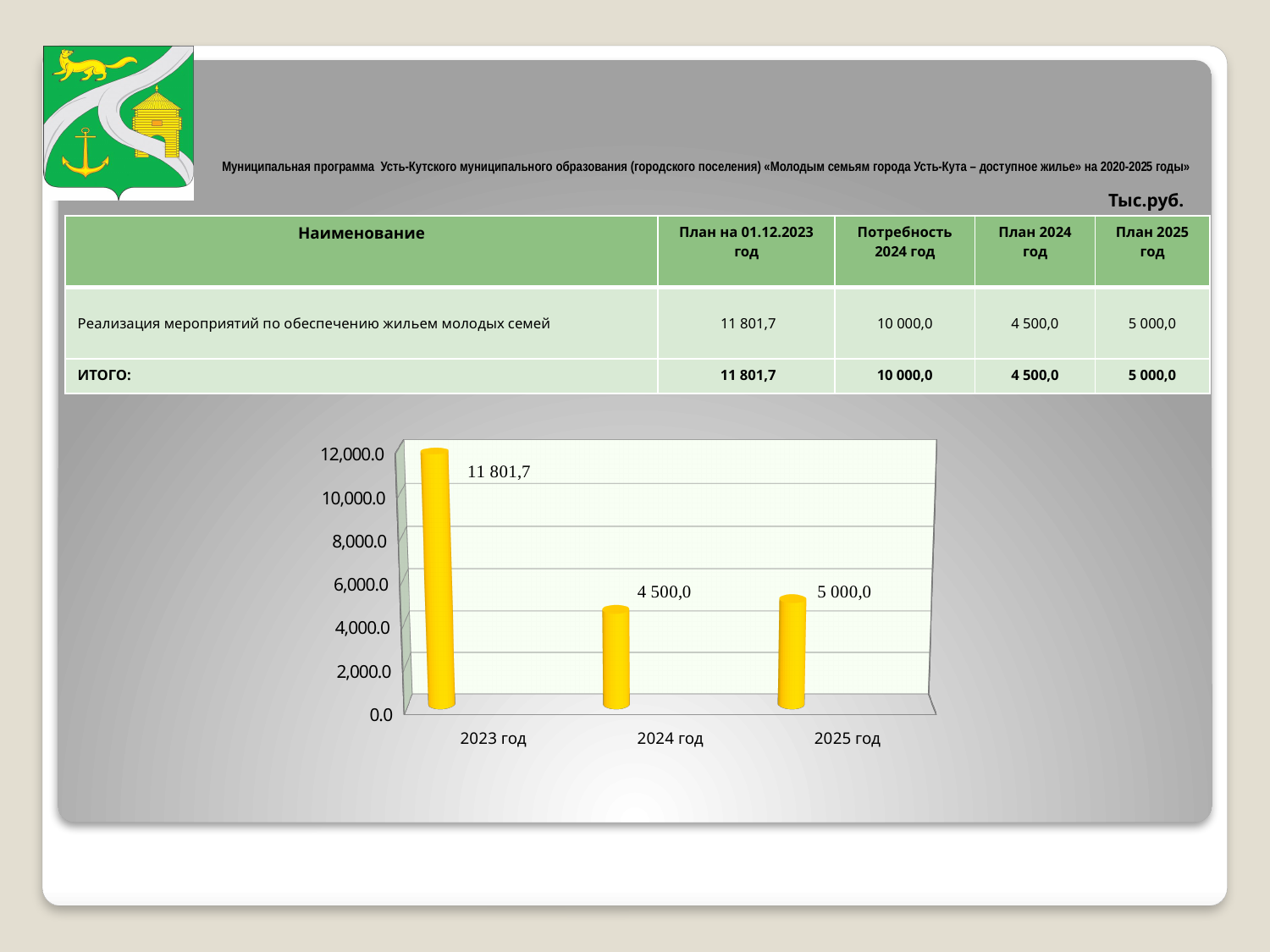
What is the value shown for 2023 год in the chart? 11 801,7 What is the value shown for 2025 год in the chart? 5 000,0 What kind of chart is shown on the slide? bar chart Which is larger, the value for 2024 год or the value for 2025 год? 2025 год How many categories are shown on the x axis of the chart? 3 Is the value for 2023 год greater or less than 10,000.0? greater What is the value shown for 2024 год in the chart? 4 500,0 What is the difference between the values for 2023 год and 2024 год? 7 301,7 What is the maximum value shown on the chart's vertical axis? 12,000.0 What is the difference between the values for 2025 год and 2024 год? 500,0 Which year has the highest value in the chart? 2023 год Which year has the lowest value in the chart? 2024 год